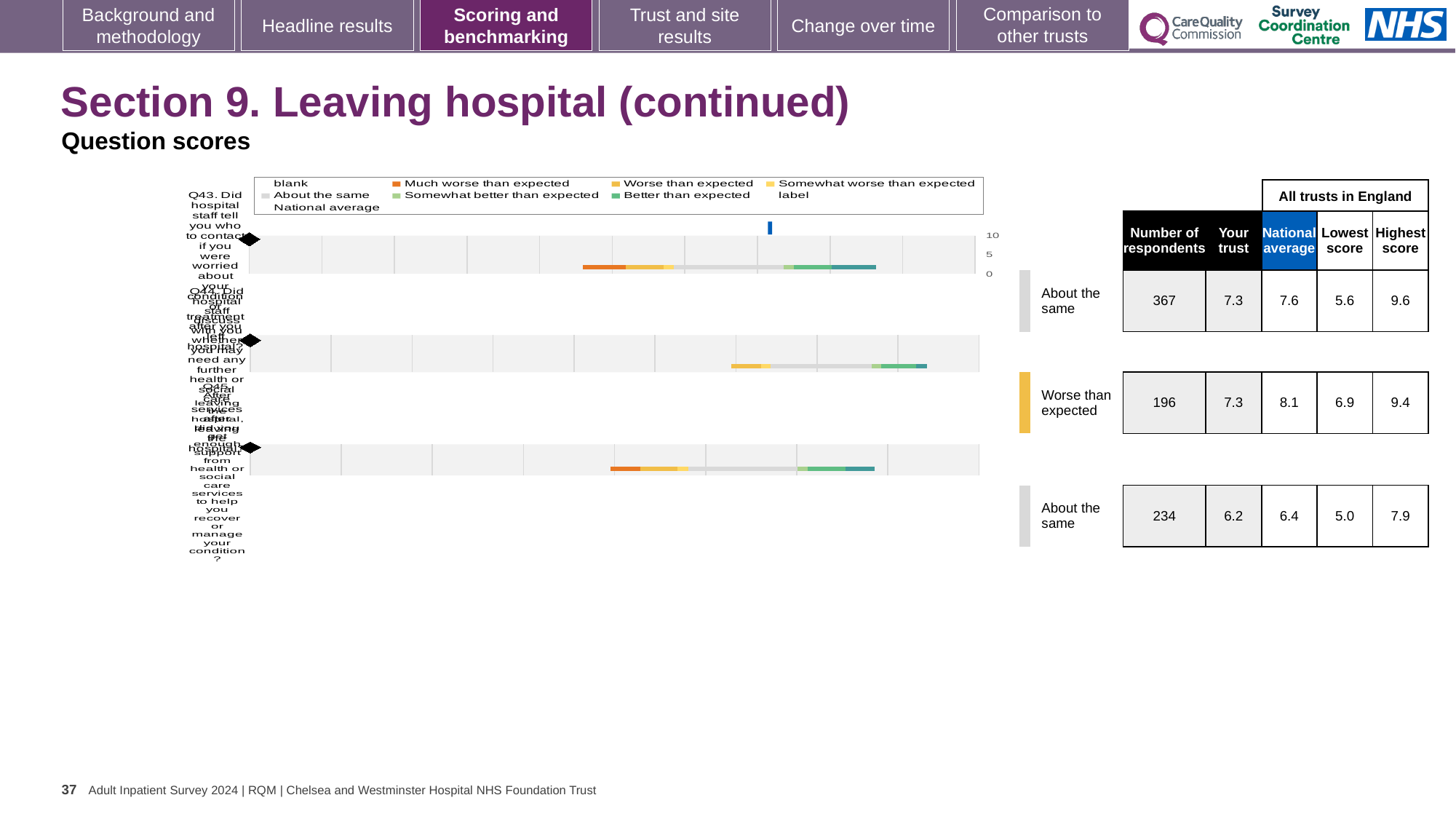
What is the highest score for the middle question row (Q44)? 9.4 Which question row has the highest number of respondents? The top row (Q43), with 367 What is the lowest score for the bottom question row (Q45)? 5.0 What kind of chart is shown on the slide? Bar chart What is the number of respondents for the top question row (Q43) in the table beside the chart? 367 What is the 'Your trust' score for the middle question row (Q44)? 7.3 For the middle question row (Q44), what is the difference between the national average and the trust's score? 0.8 Which question row is labelled 'Worse than expected'? The middle row (Q44) For the bottom question row (Q45), which is larger: the trust's score or the national average? National average (6.4) What is the national average for the middle question row (Q44)? 8.1 Which question row has the lowest 'Your trust' score? The bottom row (Q45), with 6.2 How many question rows are plotted in the chart? 3